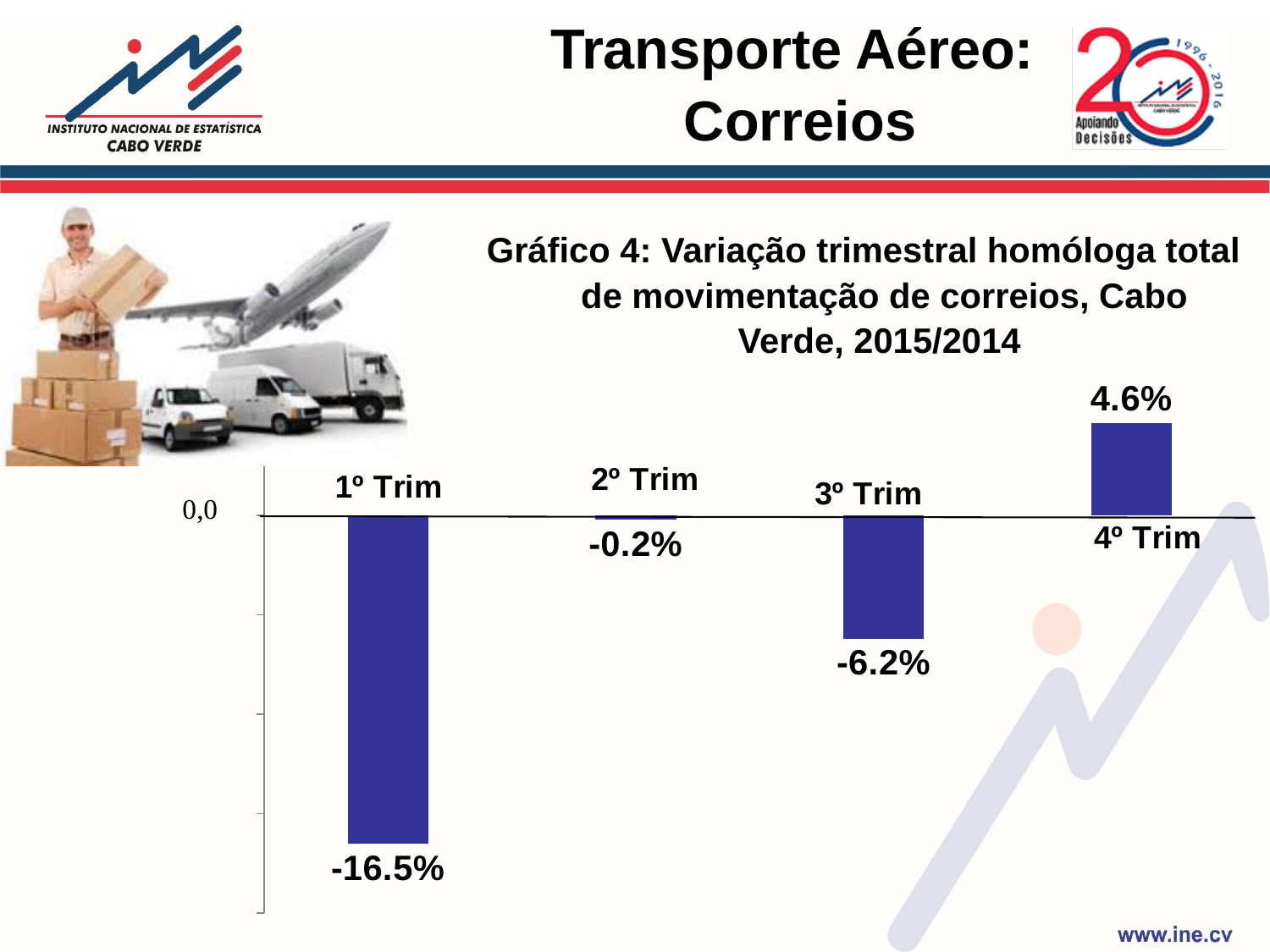
Which is larger, the value for 2º Trim or the value for 3º Trim? 2º Trim Which quarter has the highest value? 4º Trim What is the value for 3º Trim? -6.2% What is the title of the chart? Gráfico 4: Variação trimestral homóloga total de movimentação de correios, Cabo Verde, 2015/2014 What is the value for 2º Trim? -0.2% How many quarters have a negative value? 3 How many quarters are shown in the chart? 4 What is the value for 1º Trim? -16.5% What kind of chart is shown on the slide? Bar chart What is the difference between the values for 4º Trim and 3º Trim? 10.8 percentage points Which quarter has the lowest value? 1º Trim What is the value for 4º Trim? 4.6%